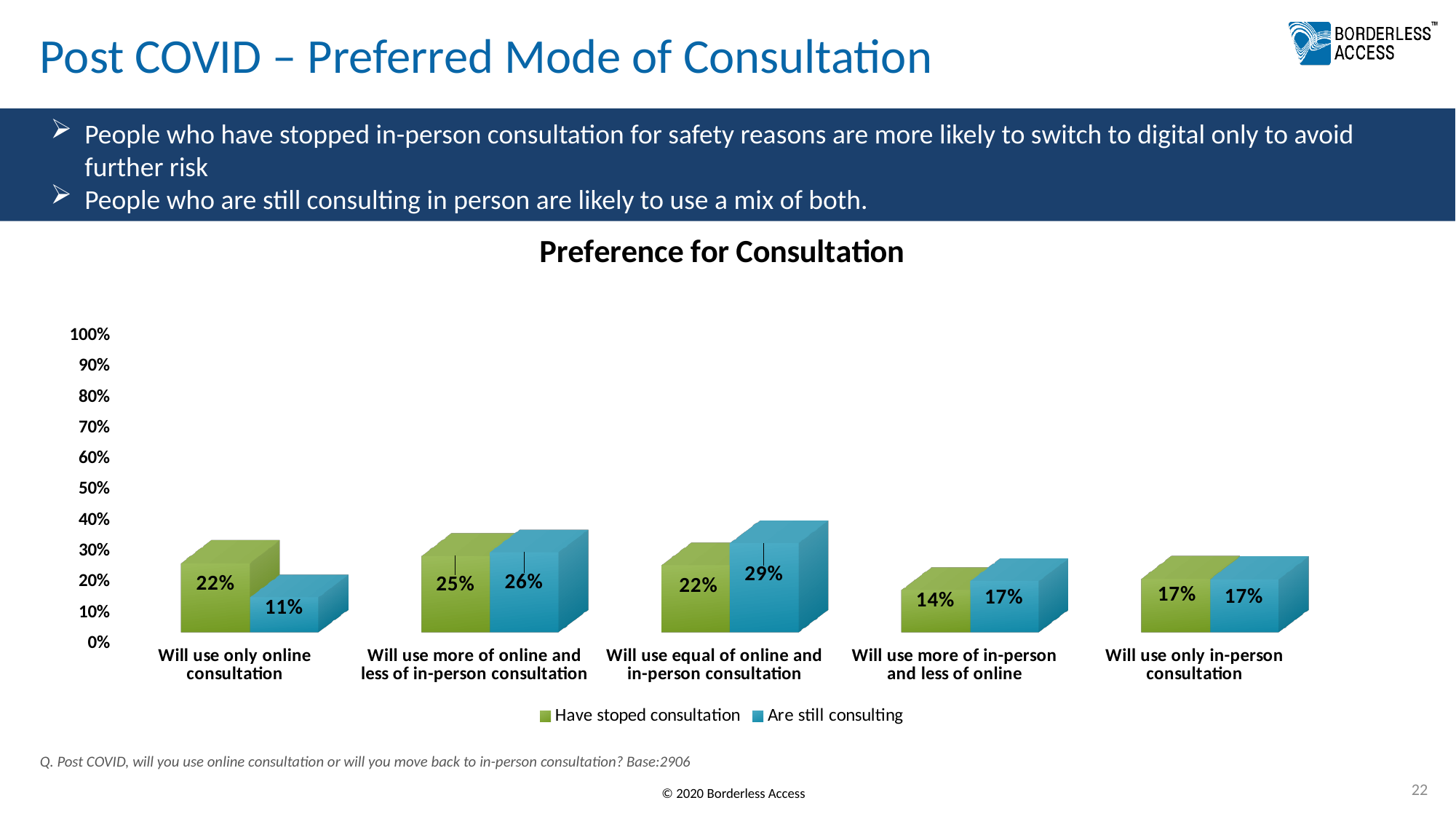
In the 'Will use equal of online and in-person consultation' category, which series has the larger value? Are still consulting What is the value for 'Have stoped consultation' in the 'Will use more of in-person and less of online' category? 14% How many categories are shown on the x axis of the chart? 5 What is the value for 'Have stoped consultation' in the 'Will use only online consultation' category? 22% Which category has the lowest value for the 'Are still consulting' series? Will use only online consultation Which category has the highest value for the 'Have stoped consultation' series? Will use more of online and less of in-person consultation Which category has the highest value for the 'Are still consulting' series? Will use equal of online and in-person consultation How many series does the legend list? 2 What type of chart is shown on the slide? Bar chart What is the difference between the 'Have stoped consultation' and 'Are still consulting' values in the 'Will use only online consultation' category? 11% What is the value for 'Are still consulting' in the 'Will use equal of online and in-person consultation' category? 29% What is the value for 'Are still consulting' in the 'Will use only online consultation' category? 11%